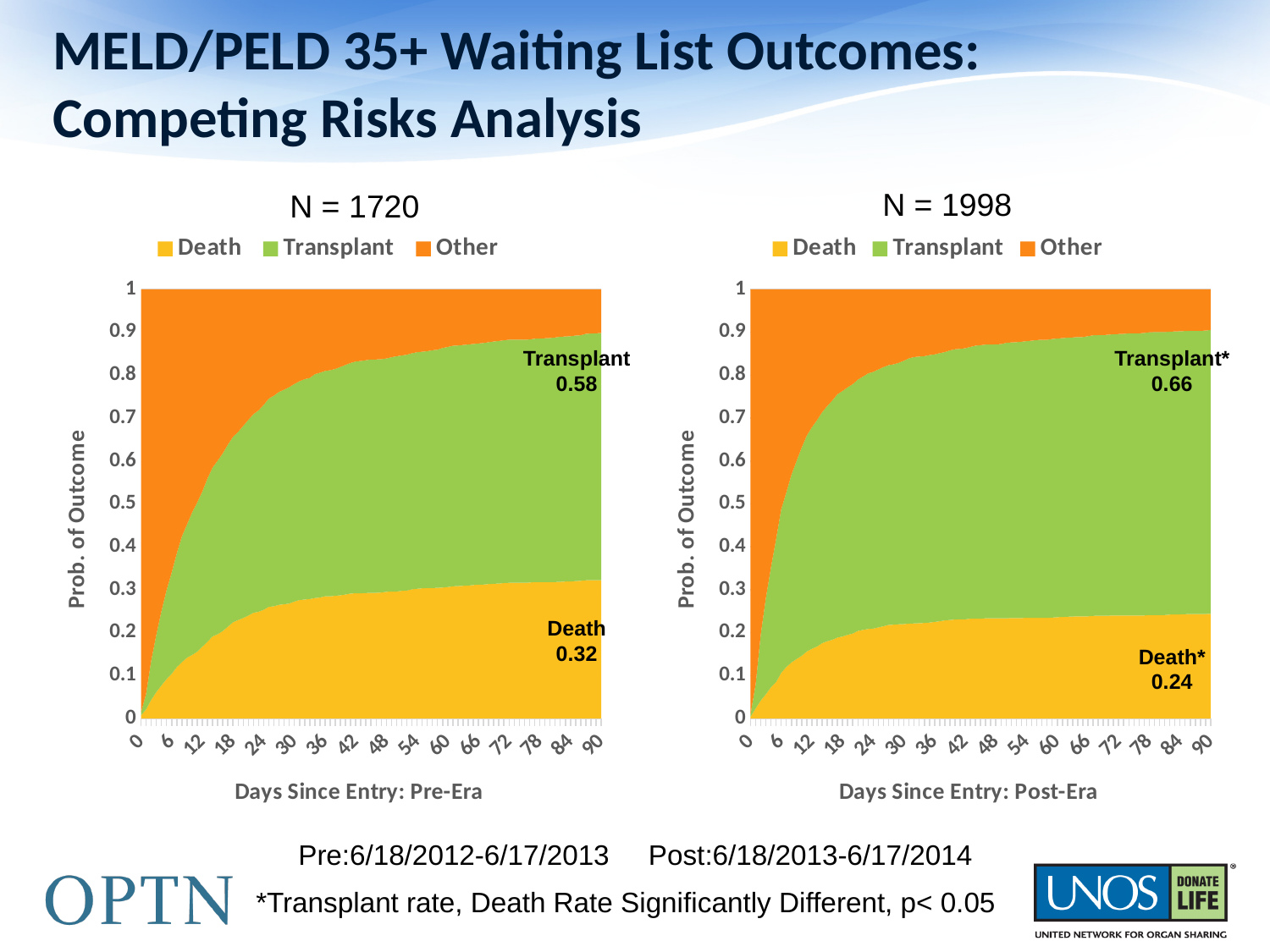
In the Post-Era chart (right), what is the labelled probability of Transplant? 0.66 How many series does the legend of the Pre-Era chart list? 3 In the Pre-Era chart (left), what is the labelled probability of Death? 0.32 What is the N shown above the Post-Era chart (right)? N = 1998 Which chart shows the higher labelled Death probability, Pre-Era or Post-Era? Pre-Era In the Pre-Era chart (left), what is the labelled probability of Transplant? 0.58 What kind of chart is used for the Pre-Era and Post-Era outcomes? Stacked area chart In the Post-Era chart (right), does the Death probability rise or fall as days since entry increase? Rise What is the difference between the labelled Death probability in the Pre-Era chart and in the Post-Era chart? 0.08 What is the difference between the labelled Transplant probability in the Post-Era chart and in the Pre-Era chart? 0.08 In the Post-Era chart (right), what is the labelled probability of Death? 0.24 In the Post-Era chart (right), is the labelled Transplant probability greater or less than 0.6? greater